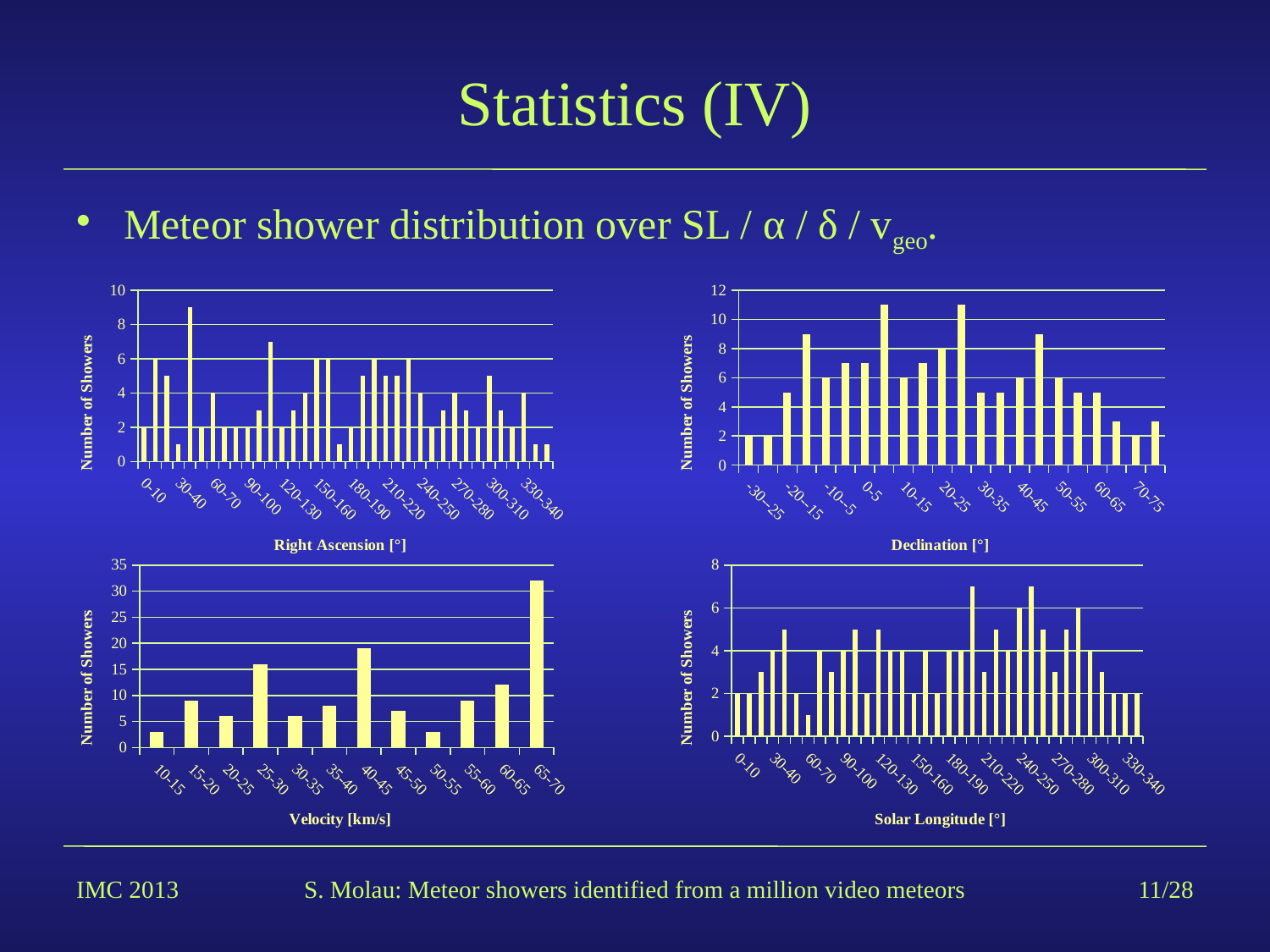
What is the y-axis label of the Right Ascension [°] chart? Number of Showers In the Solar Longitude [°] chart, what is the number of showers for the 330-340 bin? 2 In the Velocity [km/s] chart, which velocity bin has the highest number of showers? 65-70 In the Declination [°] chart, is the value for 70-75 greater or less than 4? less In the Velocity [km/s] chart, which has more showers, 40-45 or 45-50? 40-45 In the Declination [°] chart, what is the number of showers for the -30--25 bin? 2 In the Velocity [km/s] chart, is the value for 65-70 greater or less than 30? greater How many velocity bins are shown in the Velocity [km/s] chart? 12 What kind of chart is the Velocity [km/s] chart? bar chart In the Velocity [km/s] chart, is the value for 10-15 greater or less than 5? less In the Solar Longitude [°] chart, what is the number of showers for the 0-10 bin? 2